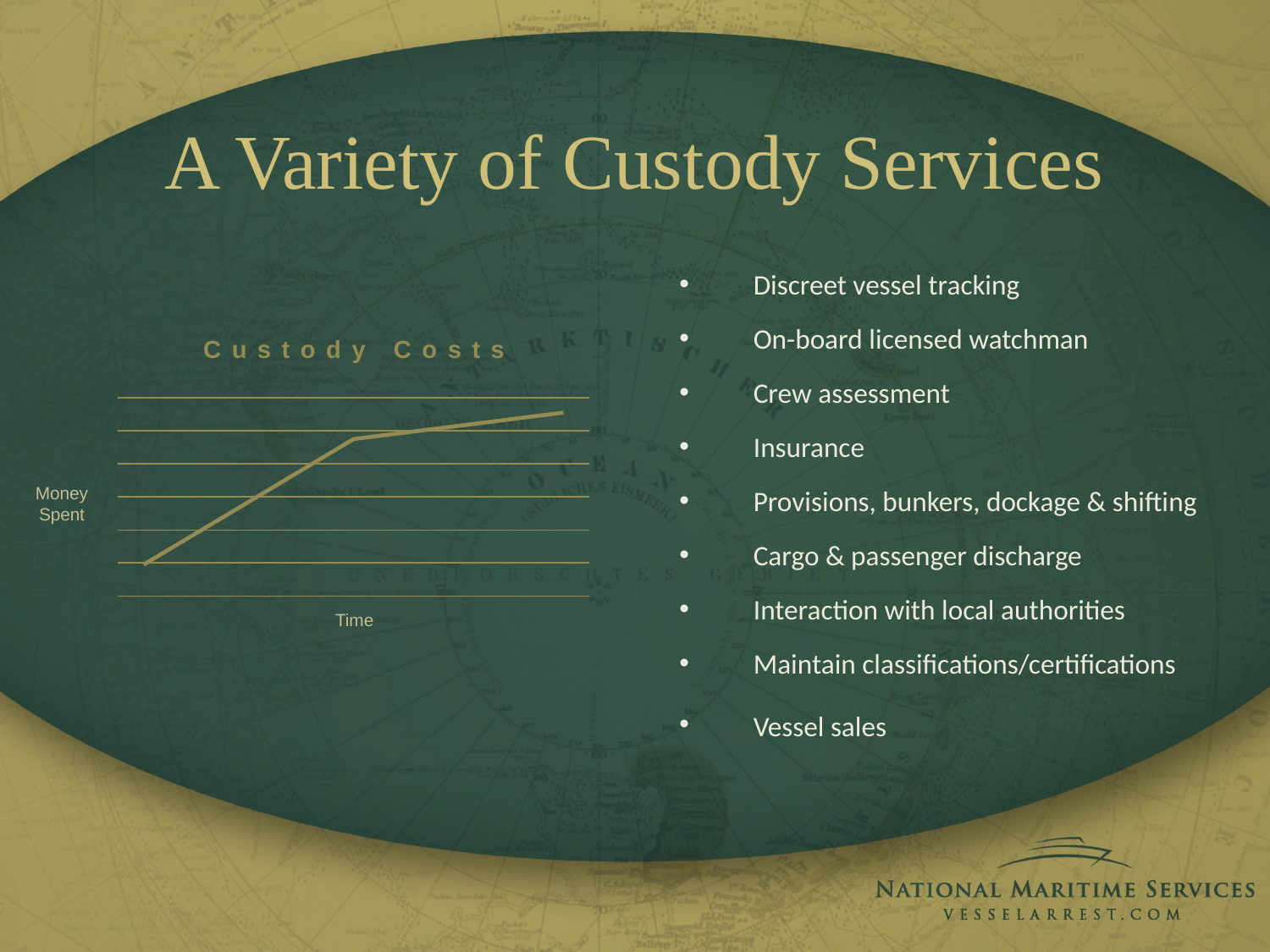
What is the title of the chart? Custody Costs What is the label on the vertical axis of the Custody Costs chart? Money Spent Do the values in the Custody Costs chart rise or fall along the x axis? Rise What kind of chart is shown on the slide? Line chart Does the line in the Custody Costs chart increase more steeply at the beginning or at the end of the Time axis? At the beginning